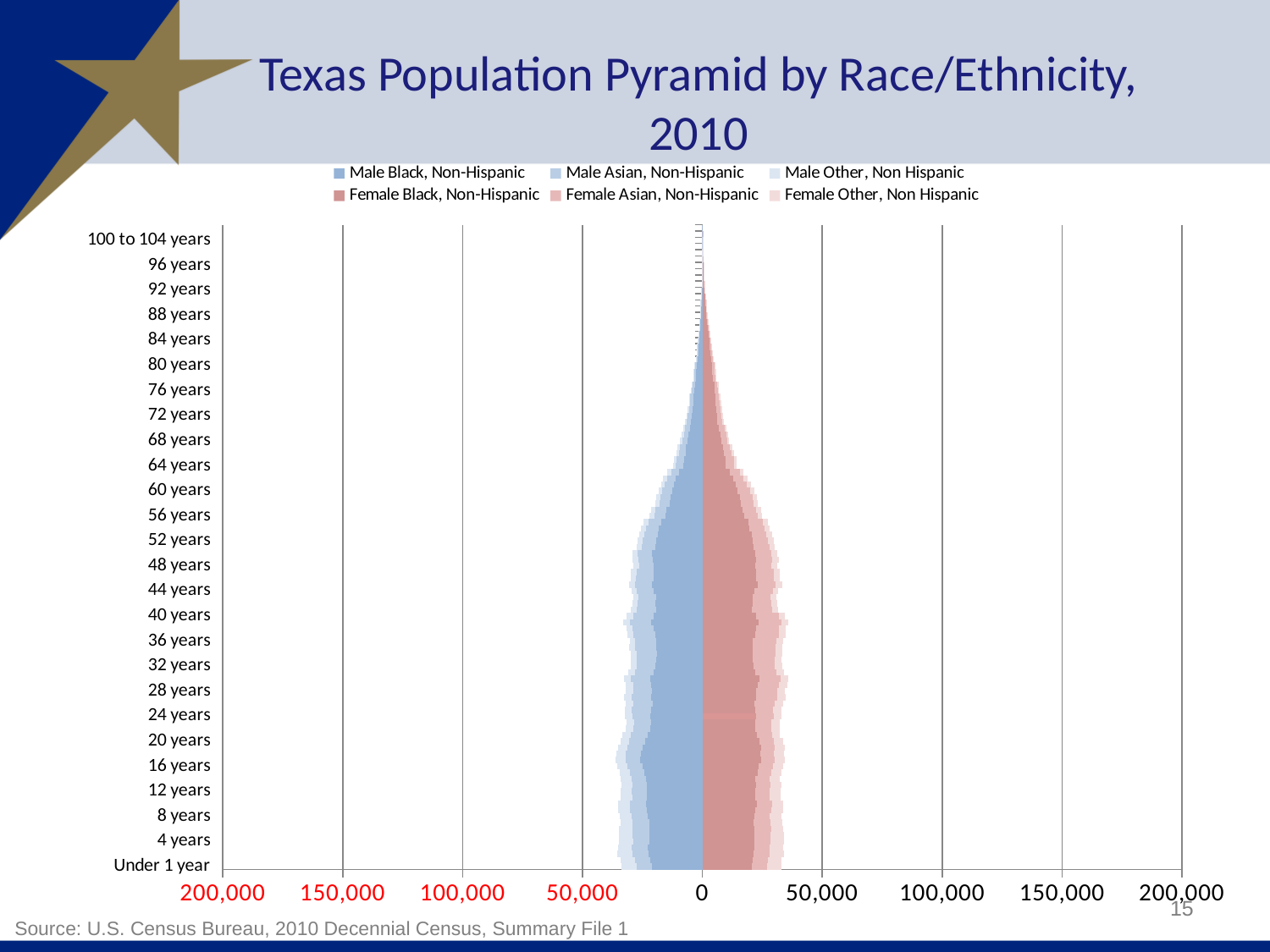
Which legend entry is shown in the darkest blue? Male Black, Non-Hispanic What is the largest value shown on the horizontal axis? 200,000 Is the total male population (all three male series combined) at 100 to 104 years greater or less than 50,000? less What is the title of the chart? Texas Population Pyramid by Race/Ethnicity, 2010 Is the total female population (all three female series combined) at 40 years greater or less than 50,000? less What kind of chart is shown on the slide? Bar chart (population pyramid) Is the value for Male Black, Non-Hispanic at Under 1 year greater or less than 50,000? less How many series does the legend list? 6 Moving from 60 years up to 100 to 104 years, do the bar lengths generally increase or decrease? decrease Which is larger for Female Black, Non-Hispanic: the value at 24 years or the value at 88 years? 24 years Which is larger for Male Black, Non-Hispanic: the value at 40 years or the value at 80 years? 40 years